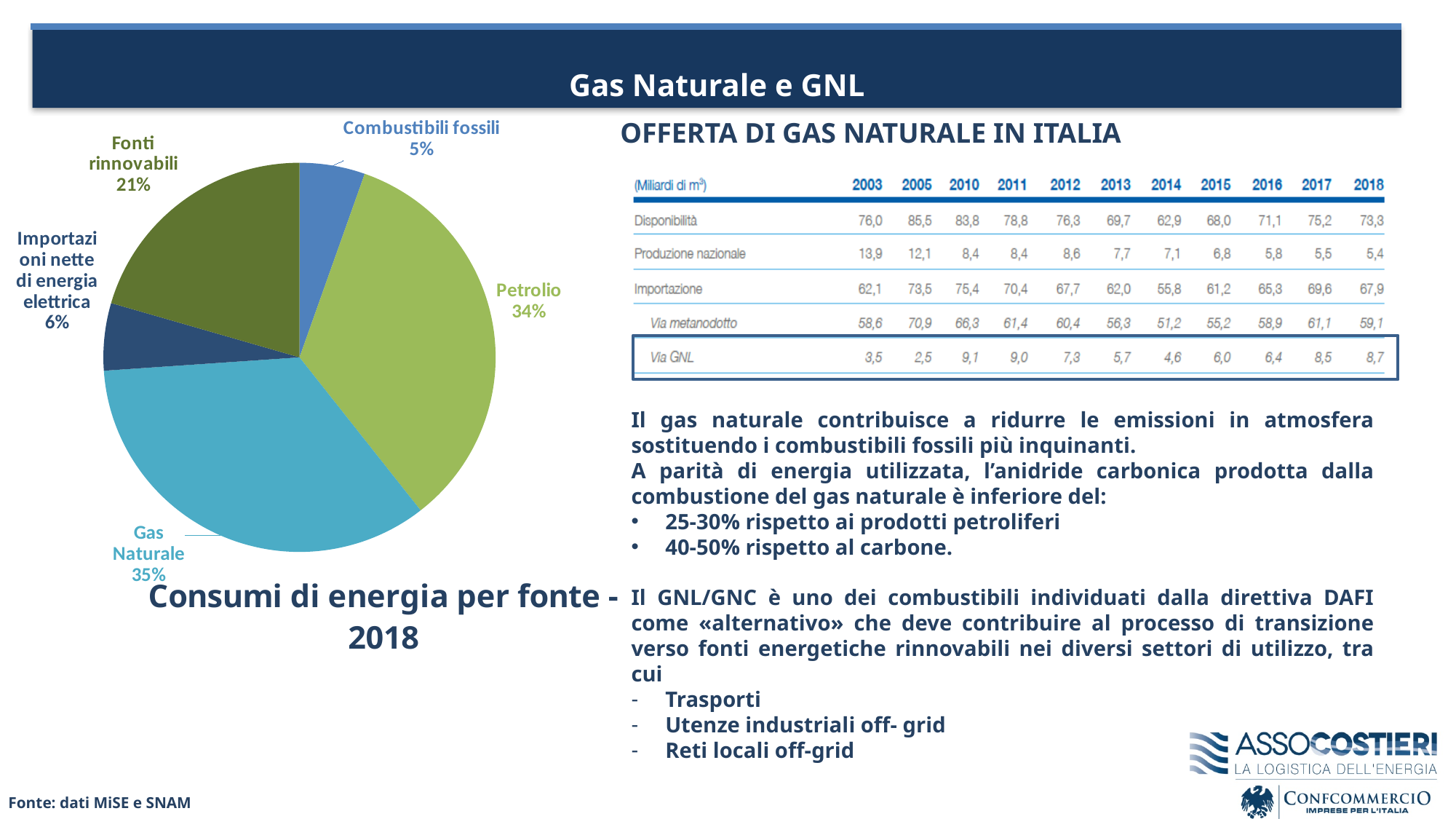
In the pie chart "Consumi di energia per fonte - 2018", which source has the smallest share? Combustibili fossili In the pie chart "Consumi di energia per fonte - 2018", how many slices are there? 5 In the pie chart "Consumi di energia per fonte - 2018", what share do Importazioni nette di energia elettrica have? 6% What is the title of the pie chart on the slide? Consumi di energia per fonte - 2018 In the pie chart "Consumi di energia per fonte - 2018", what share do Combustibili fossili have? 5% In the pie chart "Consumi di energia per fonte - 2018", which source has the largest share? Gas Naturale In the pie chart "Consumi di energia per fonte - 2018", what is the difference between the shares of Gas Naturale and Fonti rinnovabili? 14% In the pie chart "Consumi di energia per fonte - 2018", what share does Gas Naturale have? 35% In the pie chart "Consumi di energia per fonte - 2018", which is larger: Petrolio or Fonti rinnovabili? Petrolio In the pie chart "Consumi di energia per fonte - 2018", what share do Fonti rinnovabili have? 21% What type of chart is "Consumi di energia per fonte - 2018"? pie chart In the pie chart "Consumi di energia per fonte - 2018", what share does Petrolio have? 34%